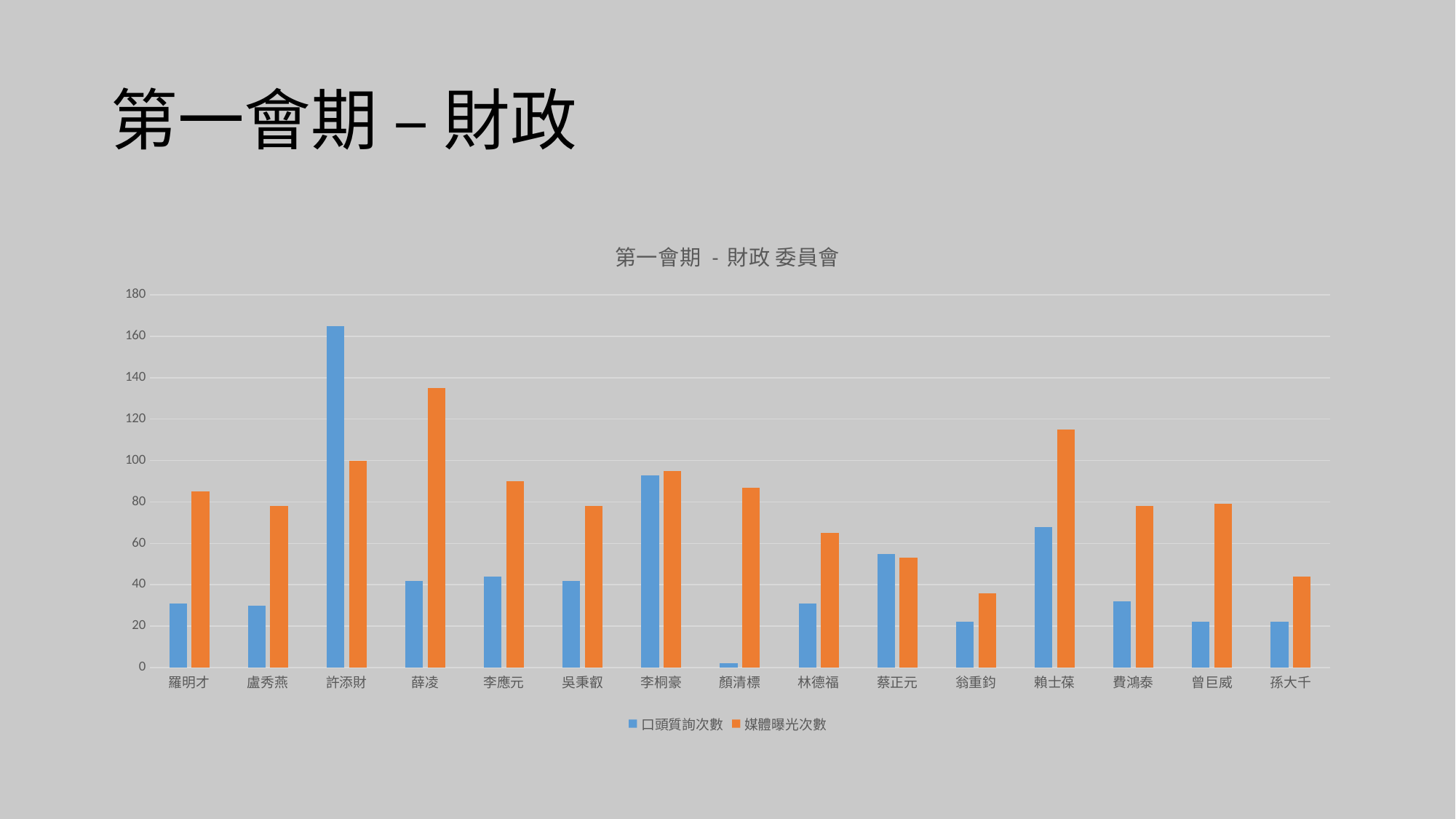
Is the 媒體曝光次數 value for 賴士葆 greater or less than 100? greater How many series does the legend list? 2 Which legislator has the lowest 口頭質詢次數? 顏清標 Which legislator has the highest 口頭質詢次數? 許添財 What kind of chart is shown on the slide? bar chart What is the title of the chart? 第一會期 - 財政 委員會 Which legislator has the lowest 媒體曝光次數? 翁重鈞 Which legislator has the highest 媒體曝光次數? 薛凌 How many legislators (categories) are shown on the x axis? 15 Is the 口頭質詢次數 value for 顏清標 greater or less than 20? less For 許添財, which is larger: 口頭質詢次數 or 媒體曝光次數? 口頭質詢次數 Is the 口頭質詢次數 value for 許添財 greater or less than 140? greater